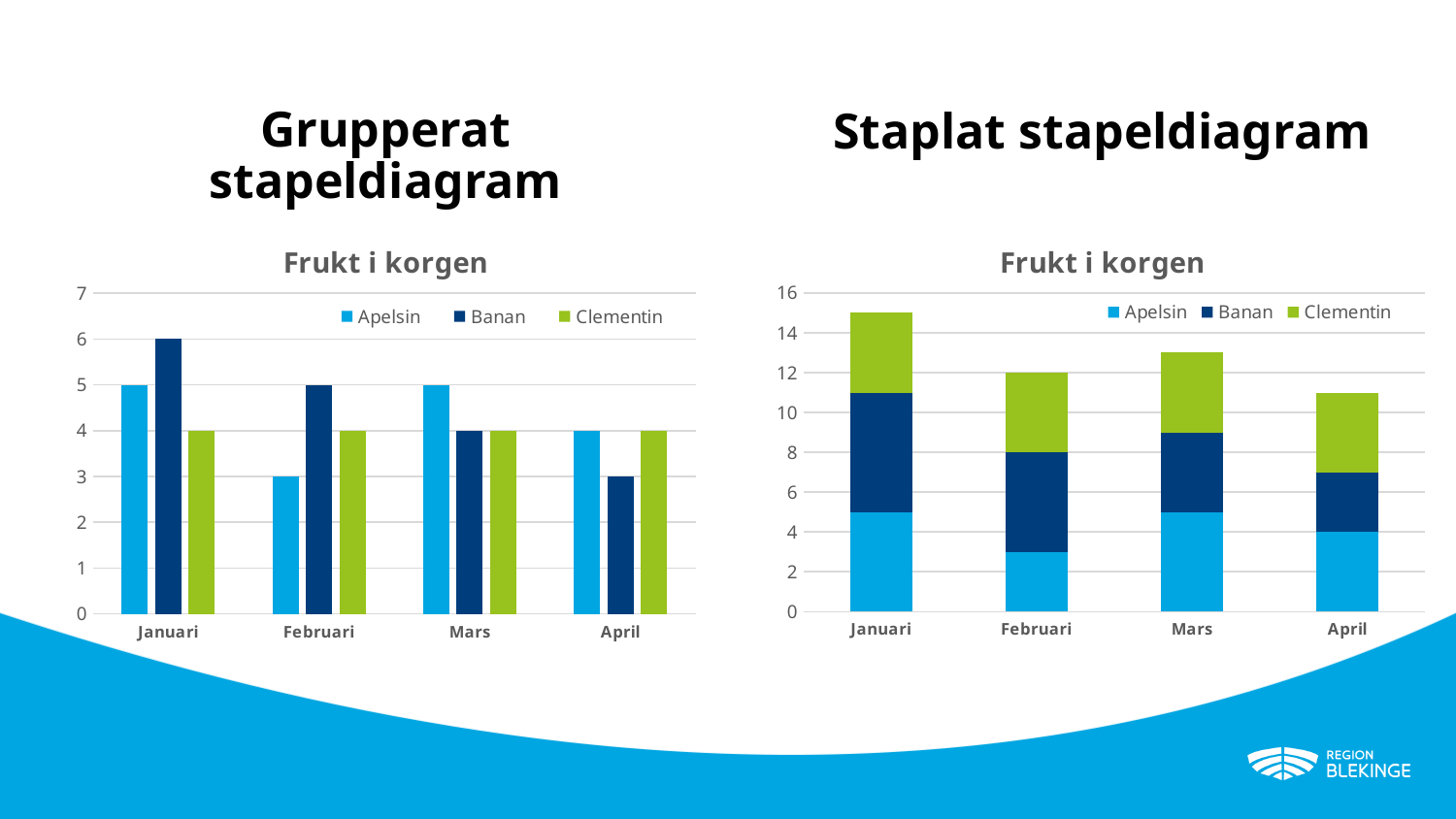
On the right chart, is the total for Januari greater or less than 14? greater On the left chart, what is the difference between Banan and Apelsin in Januari? 1 On the left chart, which is larger in Mars: Apelsin or Banan? Apelsin On the right chart, how many series does the legend list? 3 On the left chart, which series has the highest value in Januari? Banan On the left chart, what is the value for Banan in Januari? 6 On the left chart, do the Banan values rise or fall from Januari to April? fall What kind of chart is the right chart? stacked bar chart On the right chart, what is the total of the stacked bar for Februari? 12 On the left chart, how many months are shown on the x axis? 4 On the left chart, what is the value for Apelsin in Februari? 3 On the left chart, which series has the lowest value in April? Banan